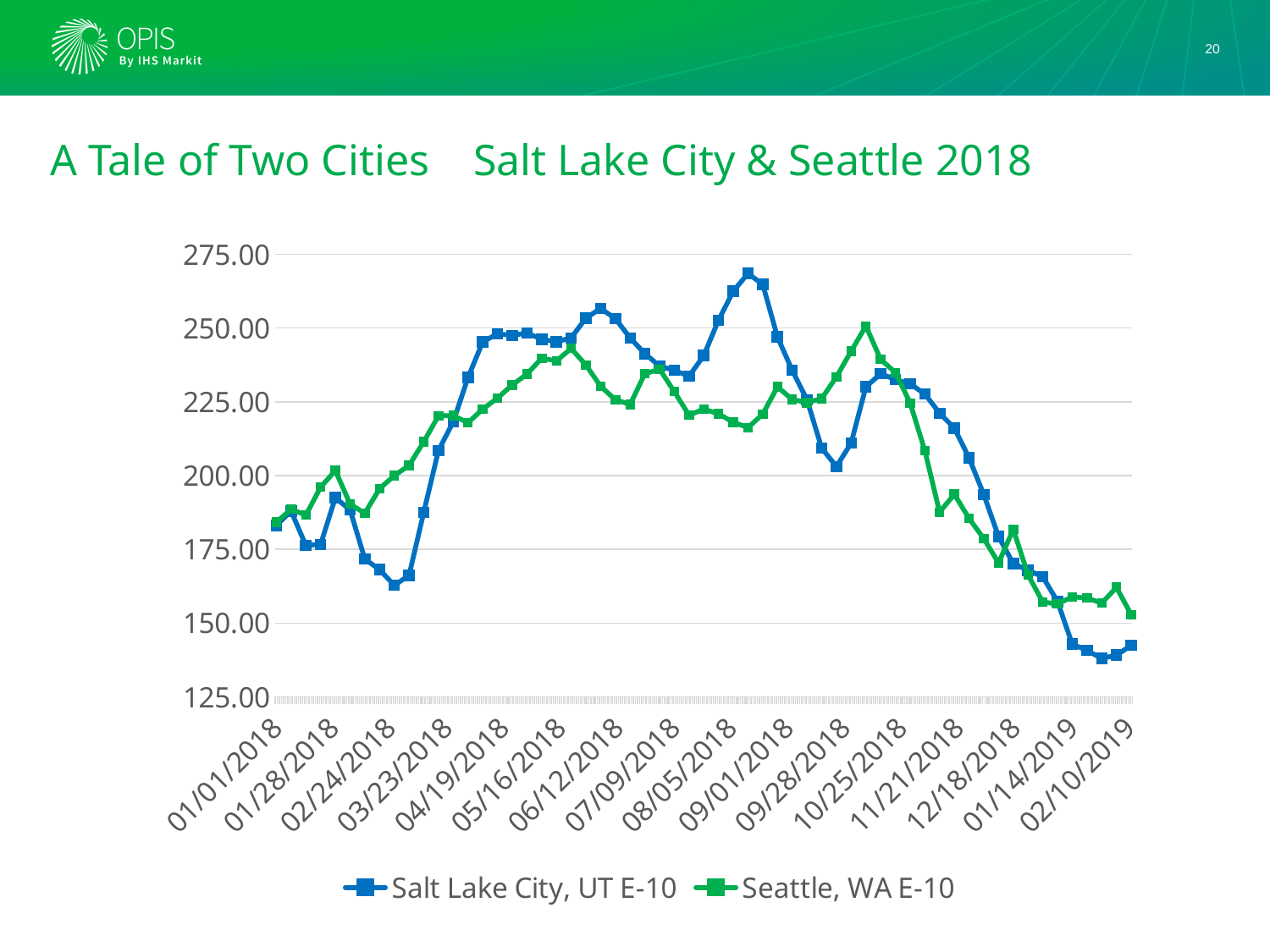
What are the two series named in the legend? Salt Lake City, UT E-10 and Seattle, WA E-10 Which series reaches the highest value anywhere on the chart? Salt Lake City, UT E-10 At 09/01/2018, which series has the higher value, Salt Lake City, UT E-10 or Seattle, WA E-10? Salt Lake City, UT E-10 Is the value for Salt Lake City, UT E-10 at 03/23/2018 greater or less than 175? greater At 03/23/2018, which series has the higher value, Salt Lake City, UT E-10 or Seattle, WA E-10? Seattle, WA E-10 What kind of chart is shown on the slide? Line chart Does the Salt Lake City, UT E-10 series rise or fall between 11/21/2018 and 02/10/2019? Fall Is the value for Seattle, WA E-10 at 01/01/2018 greater or less than 175? greater Is the value for Salt Lake City, UT E-10 at 09/01/2018 greater or less than 250? less What is the title of the slide containing the chart? A Tale of Two Cities Salt Lake City & Seattle 2018 How many series does the legend list? 2